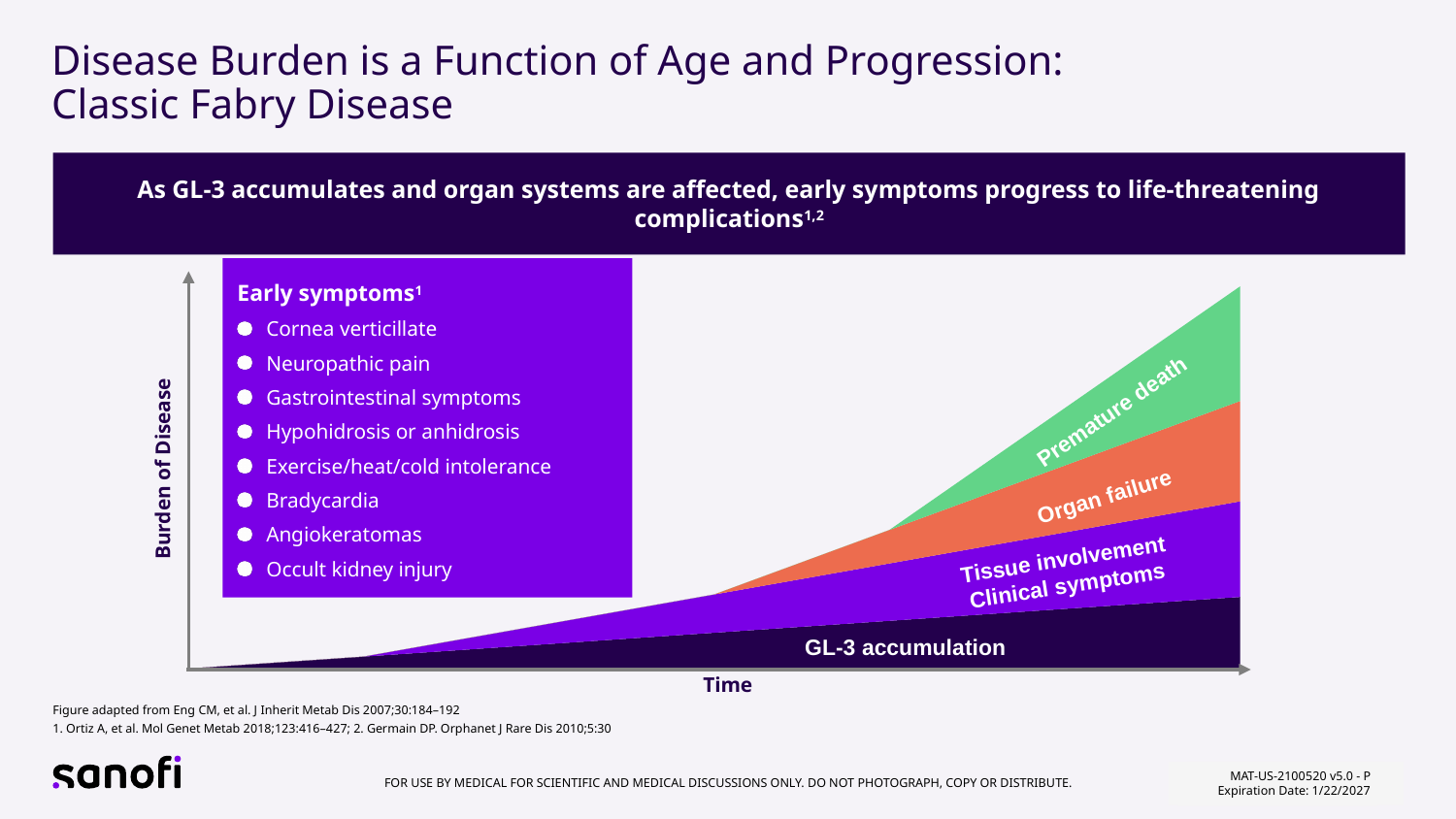
Does the burden of disease rise or fall along the Time axis in the chart? Rise How many early symptoms are listed in the 'Early symptoms' box on the chart? 8 How many labelled bands (layers) are stacked in the chart? 4 What is the label of the y axis of the chart? Burden of Disease What kind of chart is shown on the slide? Area chart What is the label of the x axis of the chart? Time